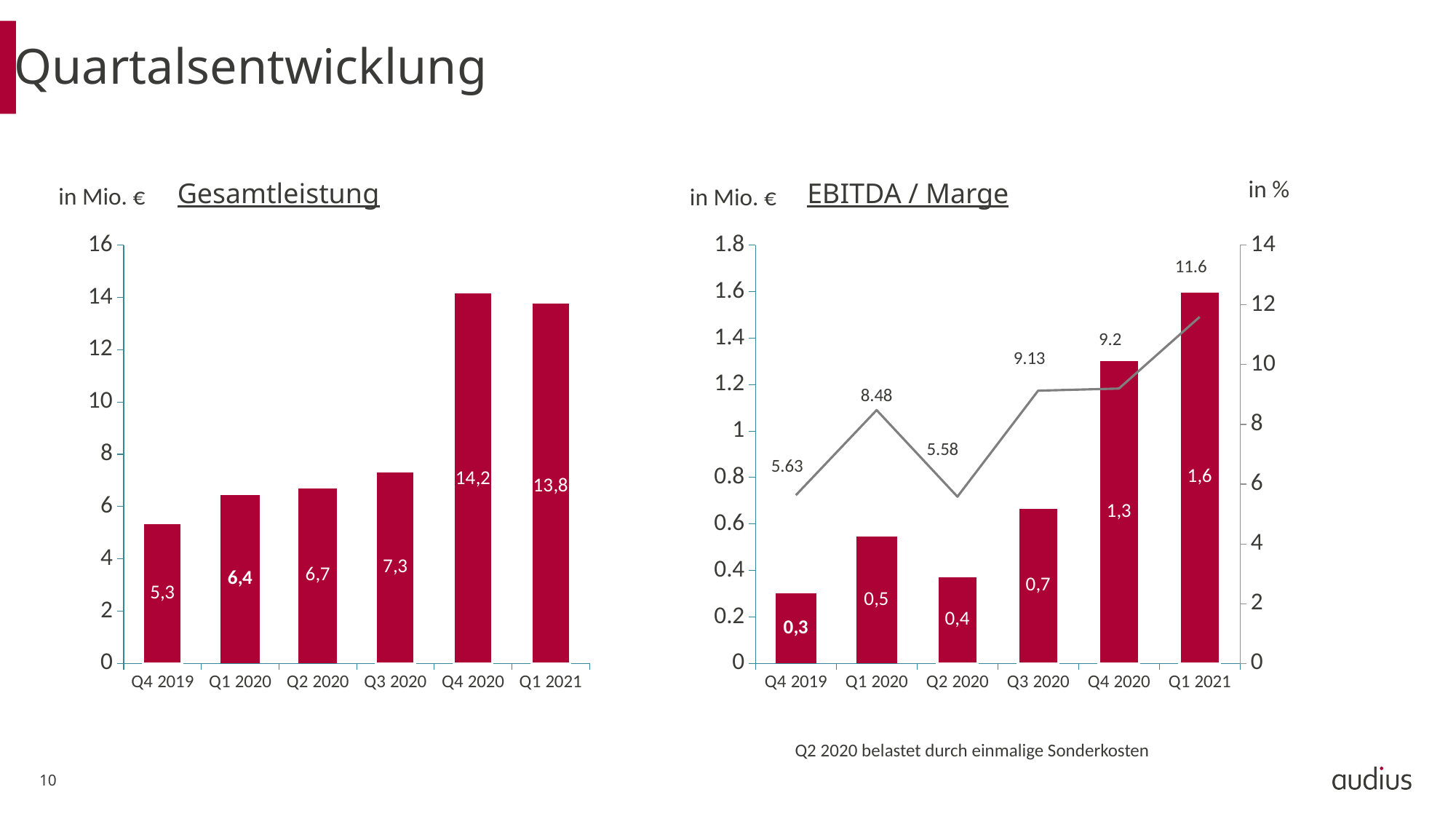
In the EBITDA / Marge chart, which quarter has the highest EBITDA bar? Q1 2021 In the Gesamtleistung chart, is the value for Q3 2020 greater or less than 8? less In the Gesamtleistung chart, how many quarters are shown on the x axis? 6 In the EBITDA / Marge chart, what is the difference between the margin values for Q1 2021 and Q4 2020? 2.4 In the Gesamtleistung chart, what is the value for Q4 2020? 14,2 In the EBITDA / Marge chart, is the EBITDA bar for Q4 2020 larger or smaller than the bar for Q3 2020? larger In the EBITDA / Marge chart, what is the margin (line) value for Q1 2020? 8.48 In the EBITDA / Marge chart, which quarter has the lowest margin value on the line? Q2 2020 In the Gesamtleistung chart, which quarter has the lowest value? Q4 2019 What unit is shown on the right-hand axis of the EBITDA / Marge chart? in % In the Gesamtleistung chart, what is the difference between Q4 2020 and Q1 2021? 0,4 In the EBITDA / Marge chart, what is the EBITDA bar value for Q3 2020? 0,7